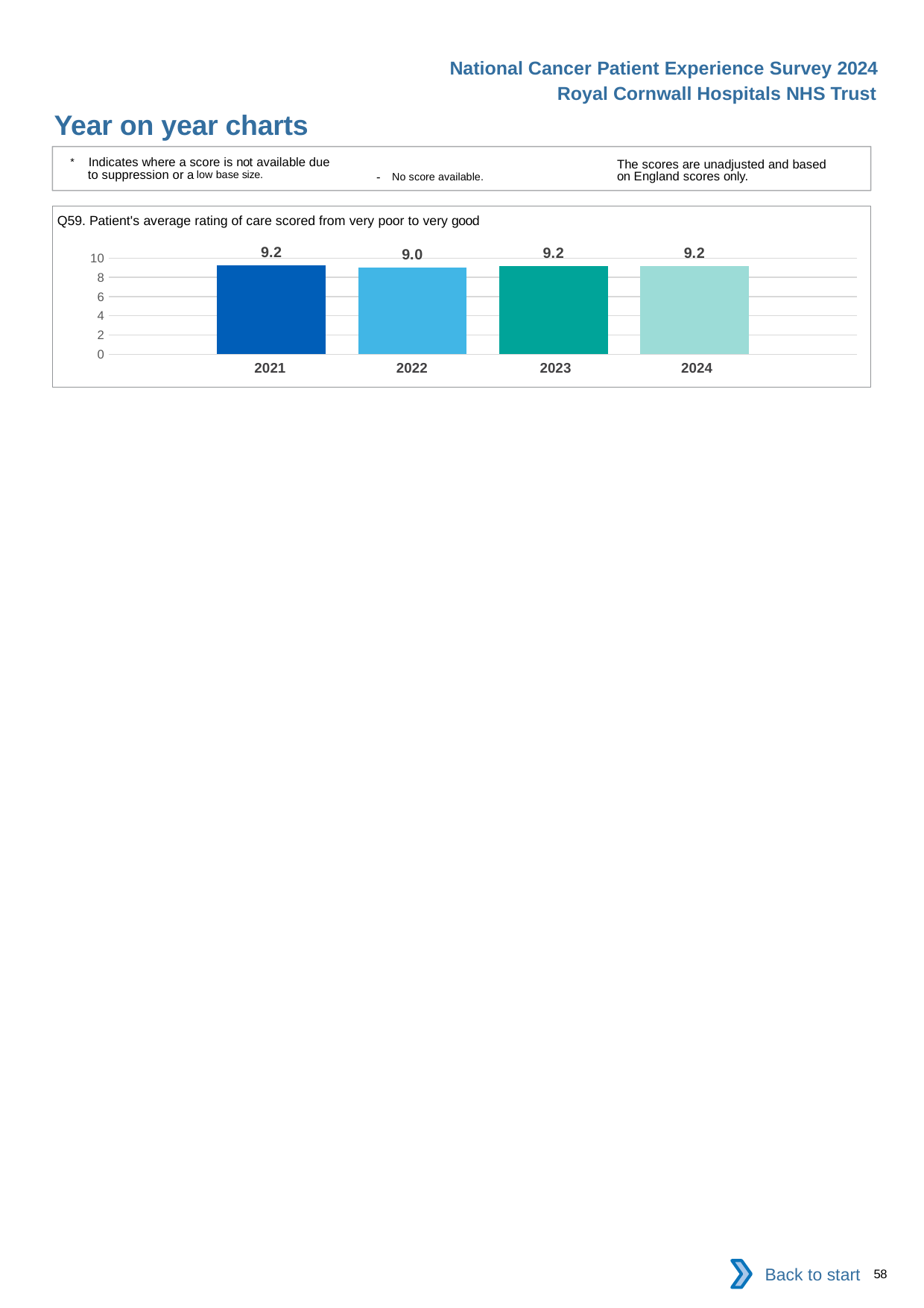
What is the difference between the values for 2021 and 2022? 0.2 What kind of chart is shown? bar chart Did the value rise or fall from 2022 to 2023? rise What is the value for 2022? 9.0 What is the value for 2021? 9.2 What is the value for 2024? 9.2 How many years are shown on the x axis? 4 Which year has the lowest value? 2022 What is the highest value shown on the y axis? 10 Is the value for 2022 greater or less than 8? greater What is the title of the chart? Q59. Patient's average rating of care scored from very poor to very good Which is larger, the value for 2022 or the value for 2023? 2023